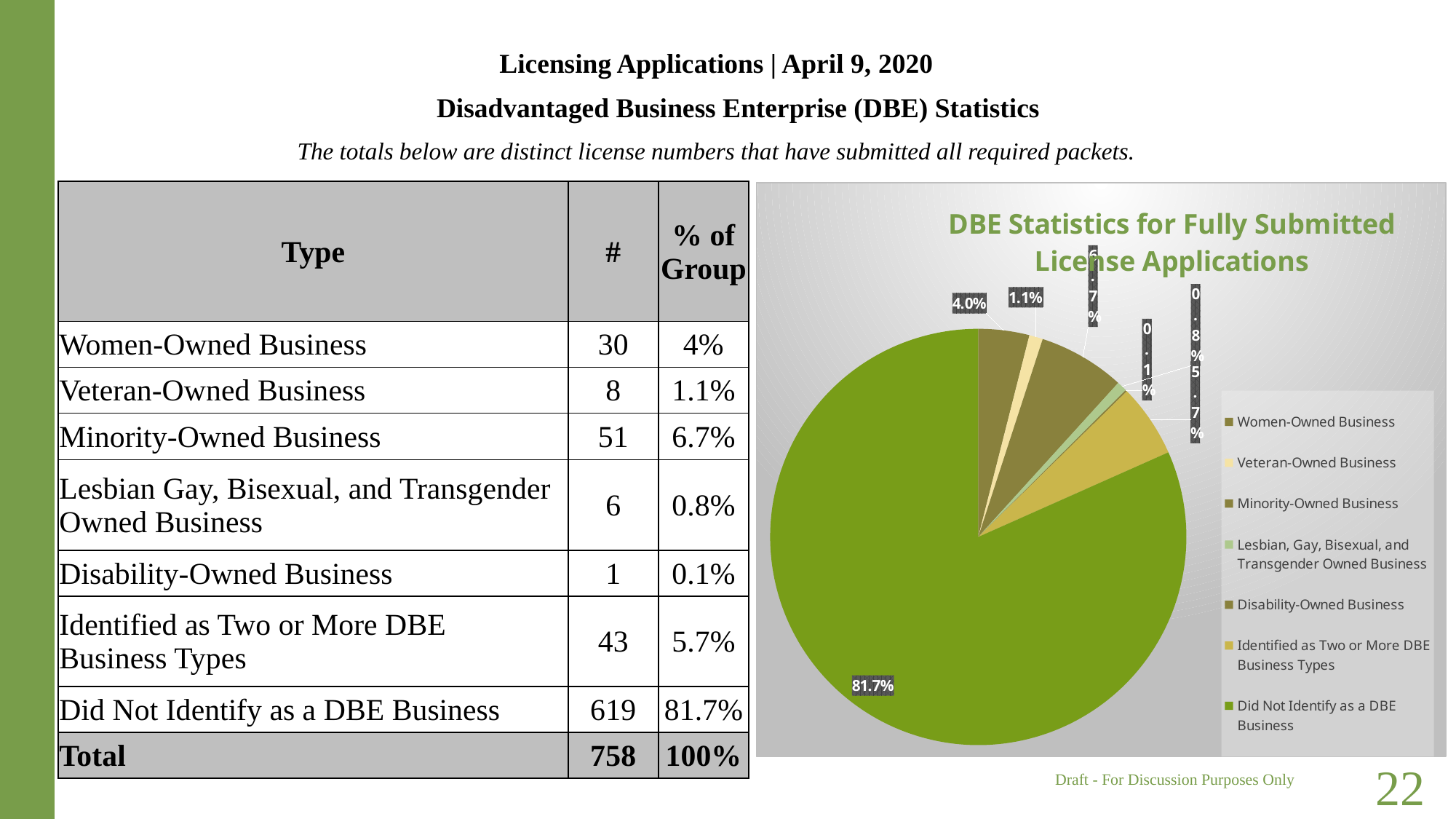
What share of the pie chart is labelled for Minority-Owned Business? 6.7% In the pie chart, which slice is larger: Minority-Owned Business or Women-Owned Business? Minority-Owned Business What is the title of the pie chart? DBE Statistics for Fully Submitted License Applications What is the difference in percentage points between the Minority-Owned Business slice and the Women-Owned Business slice in the pie chart? 2.7% How many entries does the pie chart's legend list? 7 What kind of chart is shown on the slide? pie chart Which category has the largest slice in the pie chart? Did Not Identify as a DBE Business Which category has the smallest slice in the pie chart? Disability-Owned Business What share of the pie chart is labelled for Veteran-Owned Business? 1.1% What share of the pie chart is labelled for Did Not Identify as a DBE Business? 81.7% How many slices does the pie chart have? 7